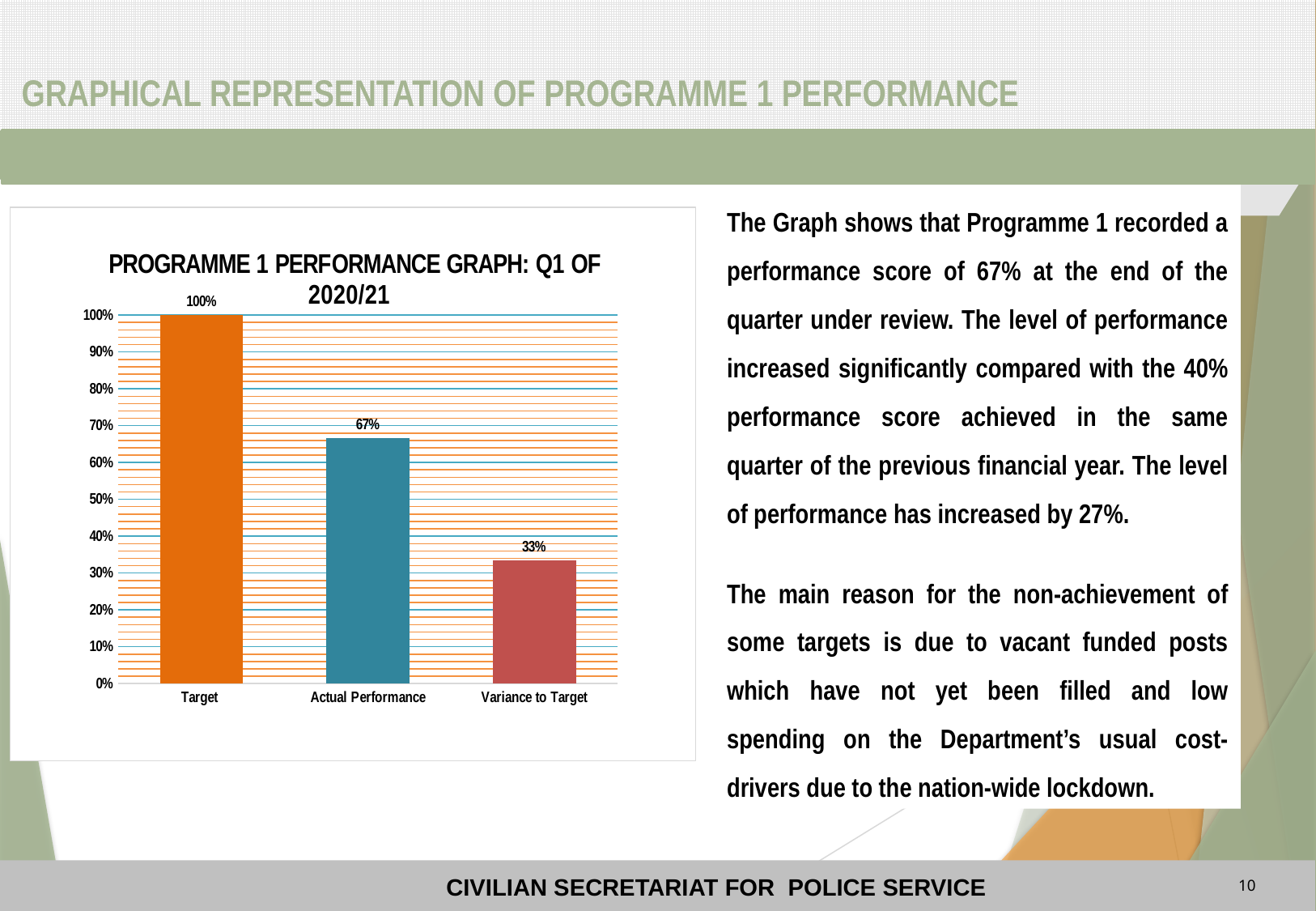
Is the value for Actual Performance greater or less than 50%? greater Which category has the lowest value? Variance to Target What is the value for Actual Performance? 67% What is the value for Target? 100% What is the value for Variance to Target? 33% What is the difference between Actual Performance and Variance to Target? 34% What is the title of the chart? PROGRAMME 1 PERFORMANCE GRAPH: Q1 OF 2020/21 What is the difference between Target and Actual Performance? 33% How many categories are shown on the x axis? 3 Which is larger, Actual Performance or Variance to Target? Actual Performance What kind of chart is shown? Bar chart Which category has the highest value? Target